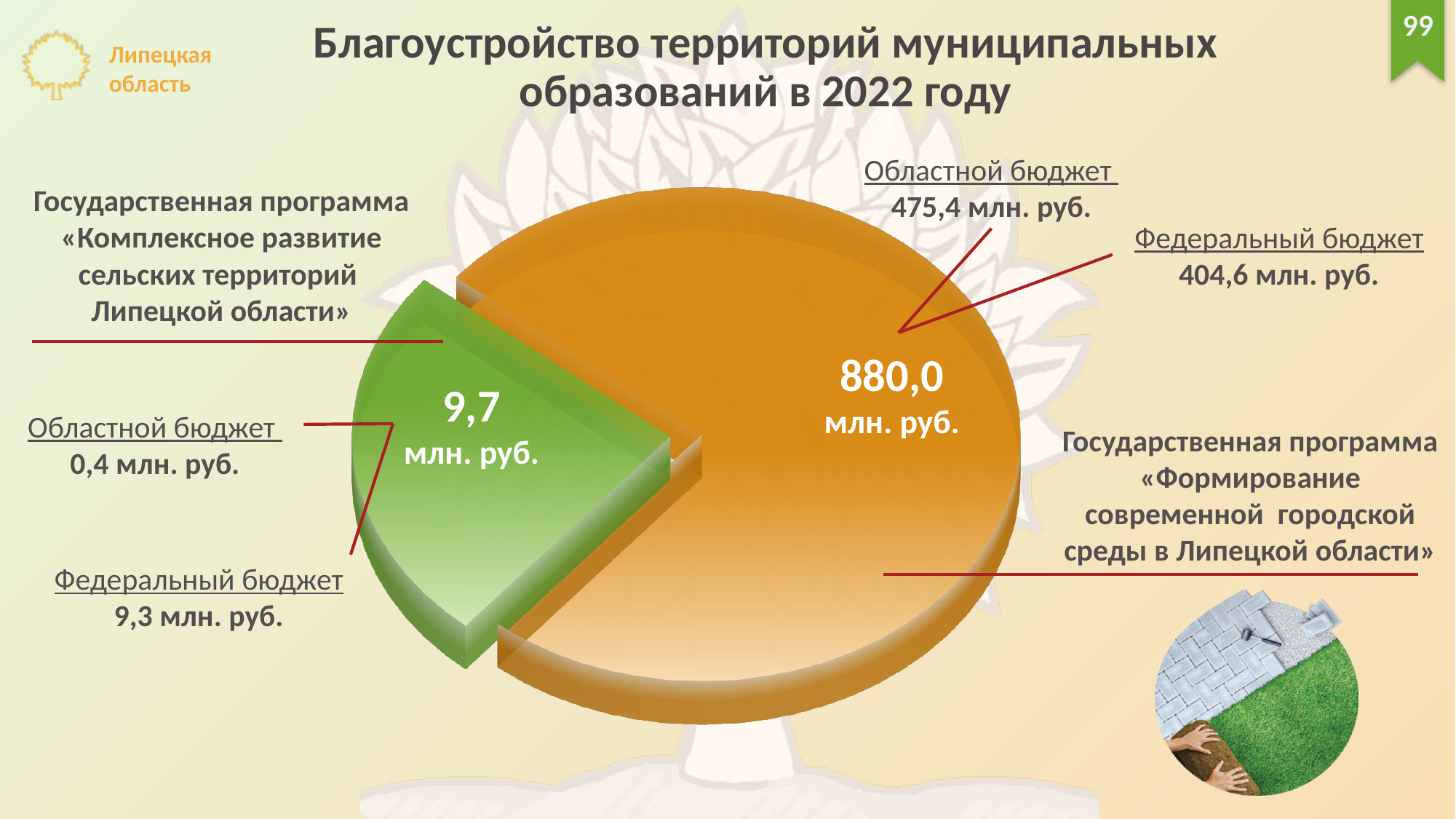
How many slices does the pie chart have? 2 Which programme has the smallest slice of the pie? «Комплексное развитие сельских территорий Липецкой области» What is the total of the two slices of the pie chart? 889,7 млн. руб. What is the value of the green slice for the programme «Комплексное развитие сельских территорий Липецкой области»? 9,7 млн. руб. What colour is the slice for the programme «Комплексное развитие сельских территорий Липецкой области»? Green What is the difference between the orange slice (880,0 млн. руб.) and the green slice (9,7 млн. руб.)? 870,3 млн. руб. What kind of chart is shown on the slide? Pie chart How much of the 880,0 млн. руб. for the urban environment programme comes from the Областной бюджет? 475,4 млн. руб. What is the value of the orange slice for the programme «Формирование современной городской среды в Липецкой области»? 880,0 млн. руб. For the rural territories programme (9,7 млн. руб.), which is larger: the Областной бюджет contribution or the Федеральный бюджет contribution? Федеральный бюджет Which programme has the largest slice of the pie? «Формирование современной городской среды в Липецкой области» How much of the 880,0 млн. руб. for the urban environment programme comes from the Федеральный бюджет? 404,6 млн. руб.